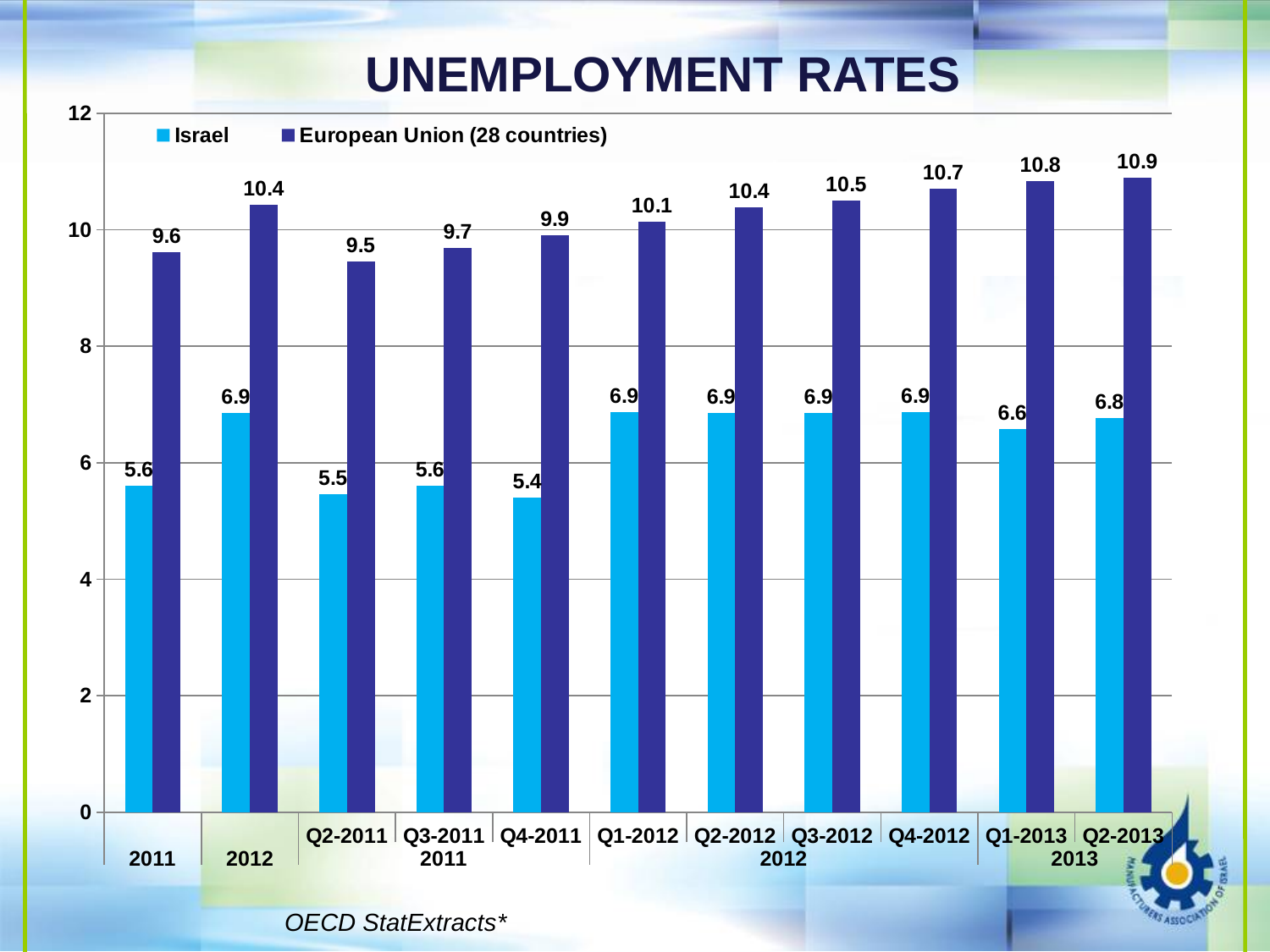
What is the difference between the European Union (28 countries) and Israel unemployment rates in Q1-2013? 4.2 What is the unemployment rate for Israel in Q4-2011? 5.4 How many categories are shown along the x axis? 11 In which category is the European Union (28 countries) unemployment rate lowest? Q2-2011 What is the title of the chart? UNEMPLOYMENT RATES What is the unemployment rate for the European Union (28 countries) in Q2-2013? 10.9 What is the unemployment rate for Israel in 2012? 6.9 What type of chart is shown on the slide? bar chart In which category is the European Union (28 countries) unemployment rate highest? Q2-2013 How many series does the legend list? 2 In which category is the Israel unemployment rate lowest? Q4-2011 Does the European Union (28 countries) unemployment rate rise or fall from Q2-2011 to Q2-2013? rise